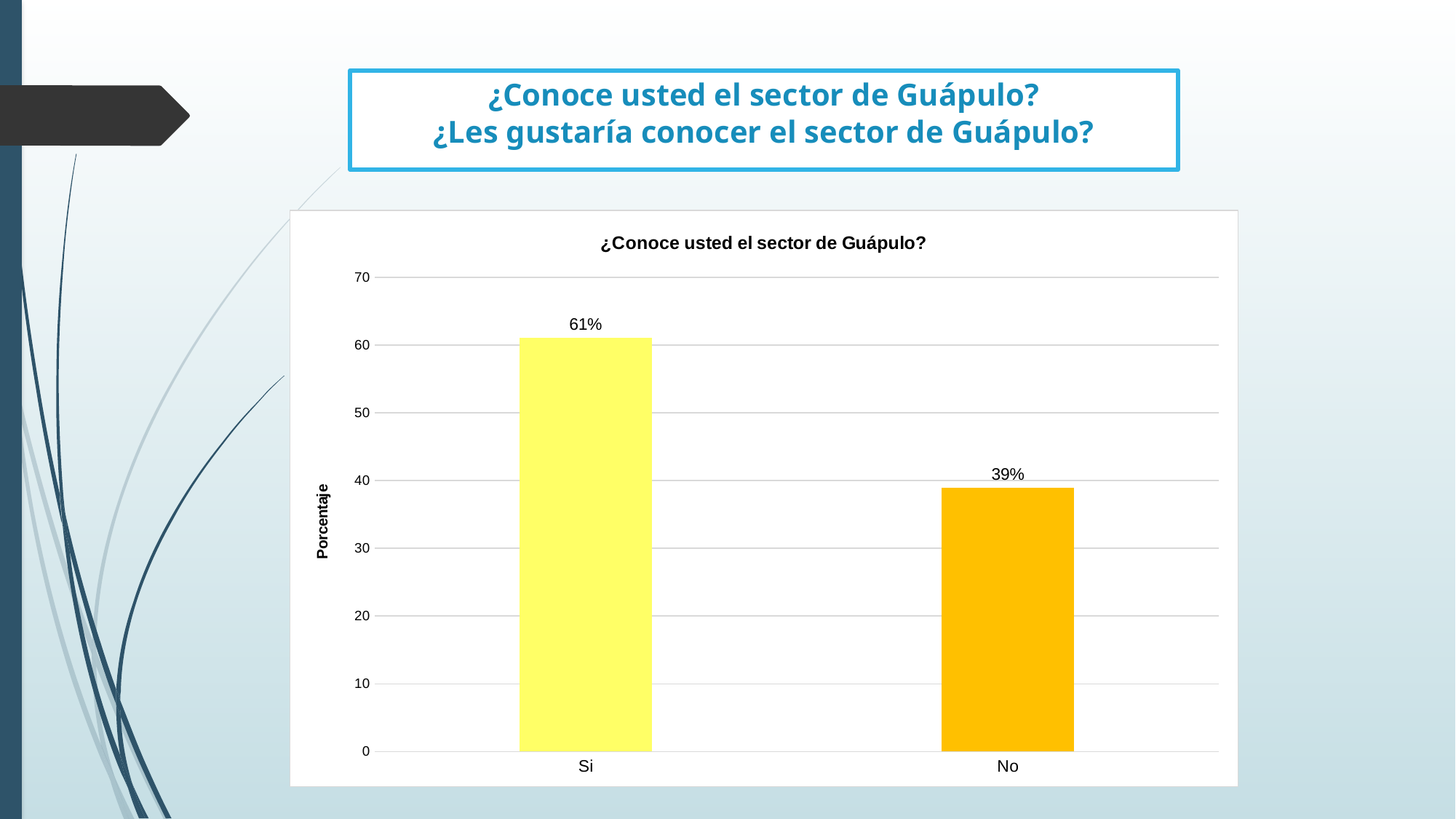
Is the value for "No" greater or less than 40? less What kind of chart is shown? bar chart What is the value for "No"? 39% Which is larger, the value for "Si" or the value for "No"? Si What is the label of the vertical axis? Porcentaje Is the value for "Si" greater or less than 60? greater What is the value for "Si"? 61% Which category has the highest value? Si How many categories are shown on the x axis? 2 Which category has the lowest value? No What is the title of the chart? ¿Conoce usted el sector de Guápulo? What is the difference between the values for "Si" and "No"? 22%